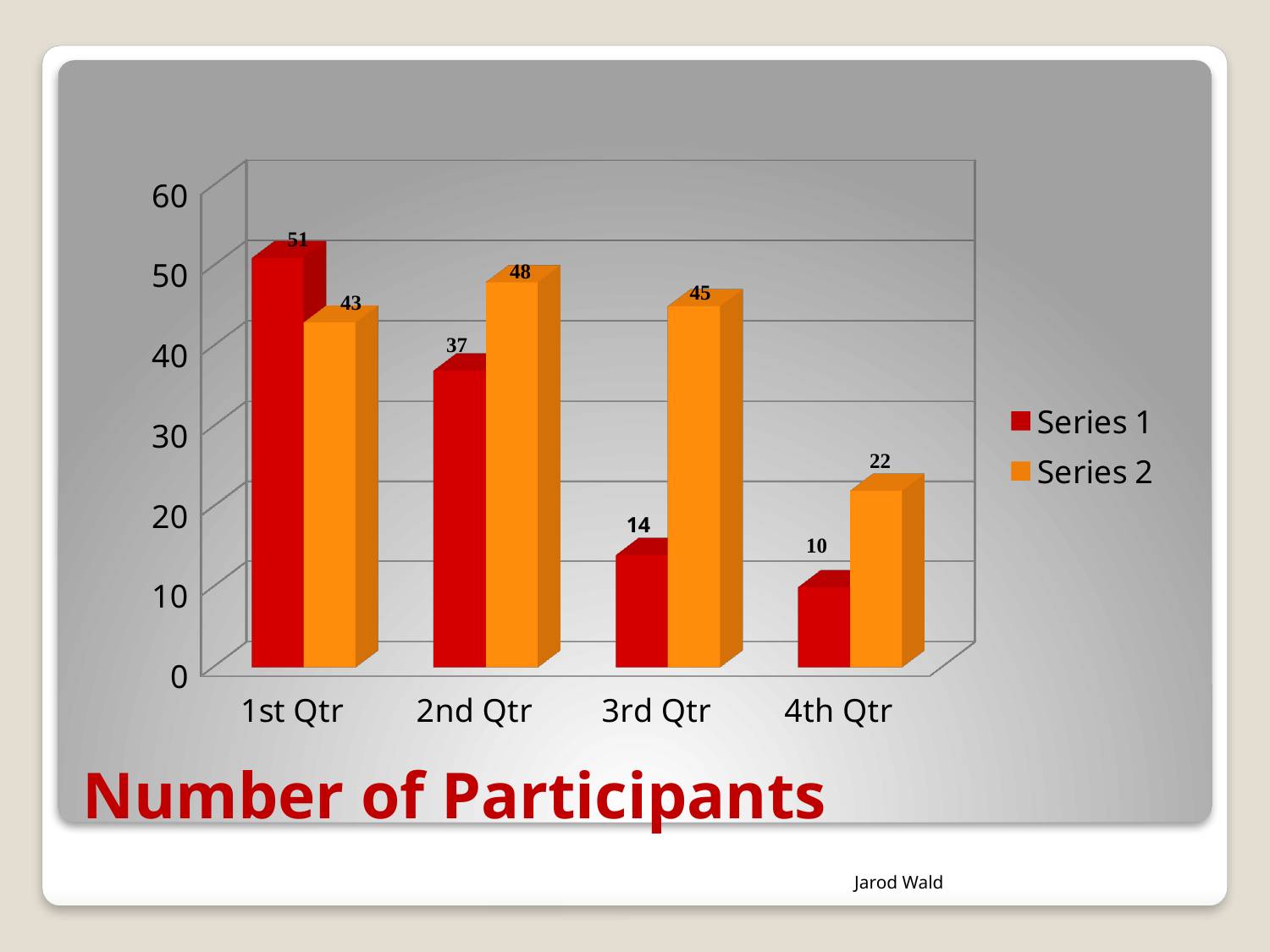
What is the value for Series 1 in 4th Qtr? 10 How many series does the legend list? 2 Which is larger in 1st Qtr, Series 1 or Series 2? Series 1 Do the Series 1 values rise or fall from 1st Qtr to 4th Qtr? fall Which quarter has the lowest value for Series 1? 4th Qtr What kind of chart is shown? bar chart How many quarters are shown on the x axis? 4 What is the difference between Series 2 and Series 1 in 3rd Qtr? 31 Which quarter has the highest value for Series 2? 2nd Qtr What is the value for Series 1 in 1st Qtr? 51 What is the value for Series 2 in 3rd Qtr? 45 Is the value for Series 2 in 4th Qtr greater or less than 30? less